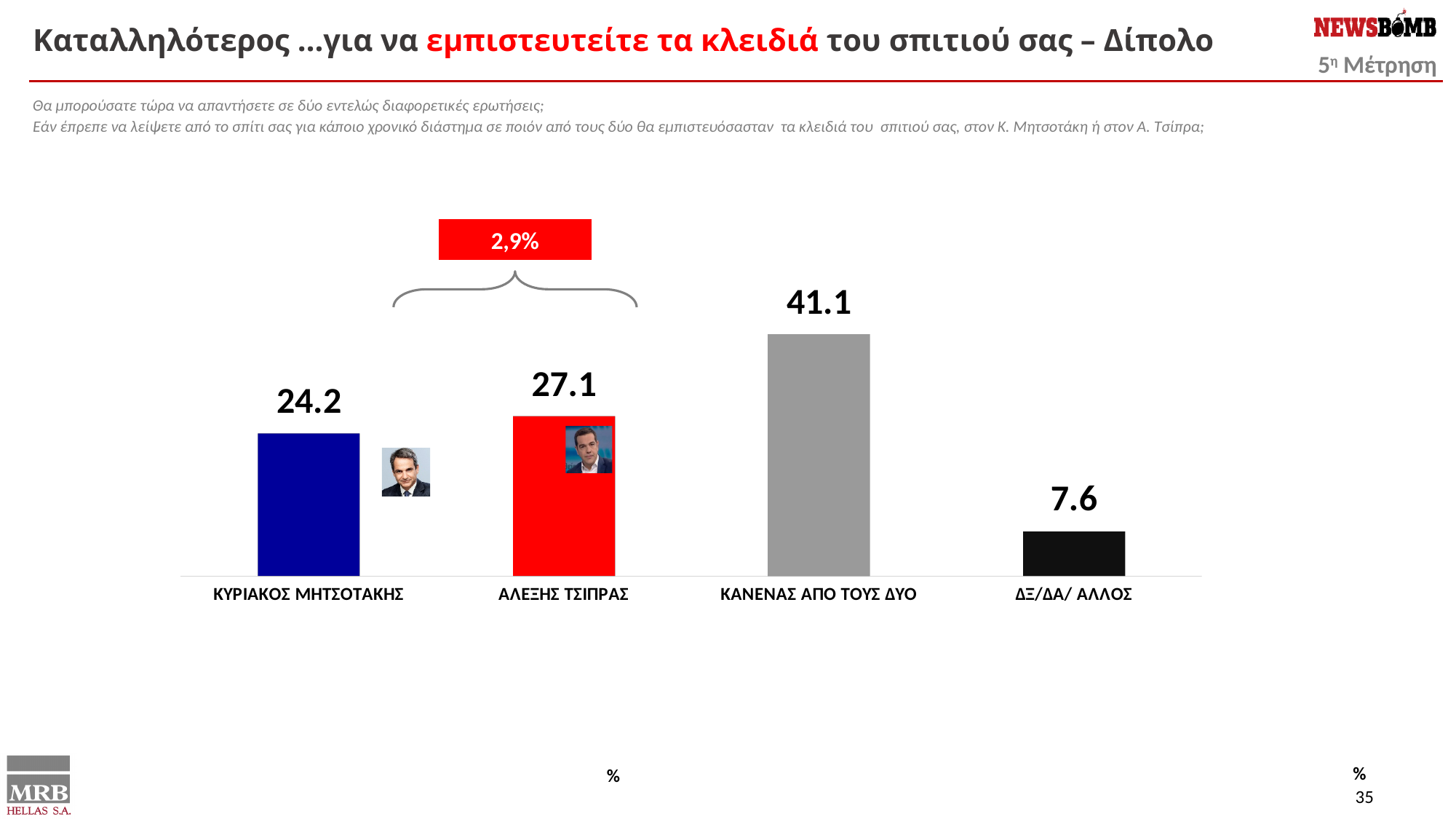
What is the value for ΚΑΝΕΝΑΣ ΑΠΟ ΤΟΥΣ ΔΥΟ? 41.1 What is the value for ΑΛΕΞΗΣ ΤΣΙΠΡΑΣ? 27.1 Which is larger, the value for ΚΥΡΙΑΚΟΣ ΜΗΤΣΟΤΑΚΗΣ or the value for ΑΛΕΞΗΣ ΤΣΙΠΡΑΣ? ΑΛΕΞΗΣ ΤΣΙΠΡΑΣ Which category has the highest value? ΚΑΝΕΝΑΣ ΑΠΟ ΤΟΥΣ ΔΥΟ What is the value for ΚΥΡΙΑΚΟΣ ΜΗΤΣΟΤΑΚΗΣ? 24.2 What is the difference between the values for ΚΑΝΕΝΑΣ ΑΠΟ ΤΟΥΣ ΔΥΟ and ΑΛΕΞΗΣ ΤΣΙΠΡΑΣ? 14.0 How many categories are shown in the chart? 4 What kind of chart is shown on the slide? Bar chart Which category has the lowest value? ΔΞ/ΔΑ/ ΑΛΛΟΣ What is the difference between the values for ΑΛΕΞΗΣ ΤΣΙΠΡΑΣ and ΚΥΡΙΑΚΟΣ ΜΗΤΣΟΤΑΚΗΣ? 2.9 What is the value for ΔΞ/ΔΑ/ ΑΛΛΟΣ? 7.6 What value is shown in the red box above the bracket linking the first two bars? 2,9%